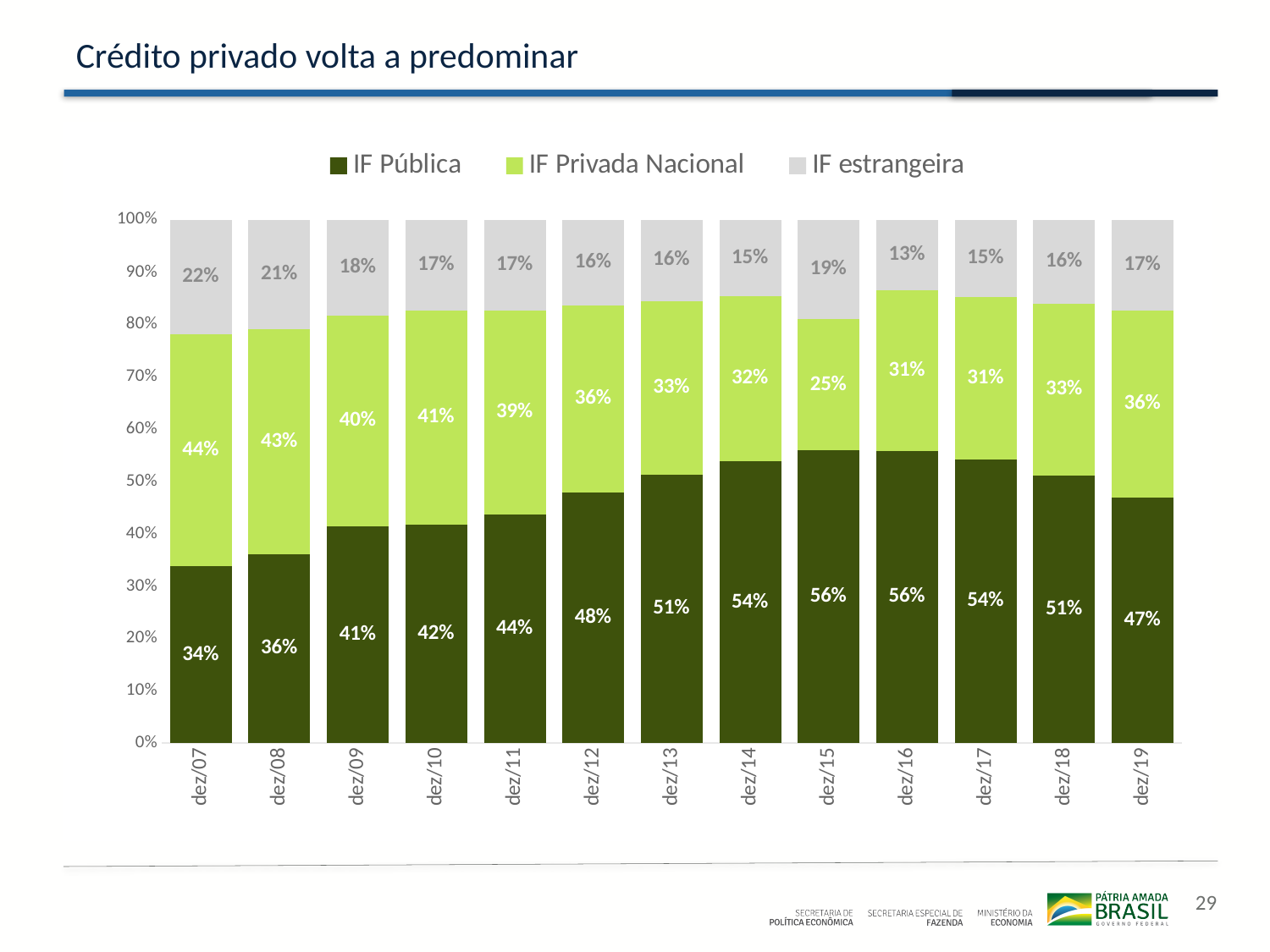
How many periods are shown on the x axis? 13 In which period is the IF Pública share lowest? dez/07 What is the difference between the IF Pública values in dez/16 and dez/07? 22 percentage points In which period is the IF estrangeira share lowest? dez/16 What is the value for IF estrangeira in dez/07? 22% Which is larger in dez/12: IF Pública or IF Privada Nacional? IF Pública What kind of chart is shown on the slide? Stacked bar chart What is the title of the slide? Crédito privado volta a predominar What is the value for IF Pública in dez/19? 47% How many series does the legend list? 3 What is the value for IF Privada Nacional in dez/15? 25% In which period is the IF Privada Nacional share highest? dez/07